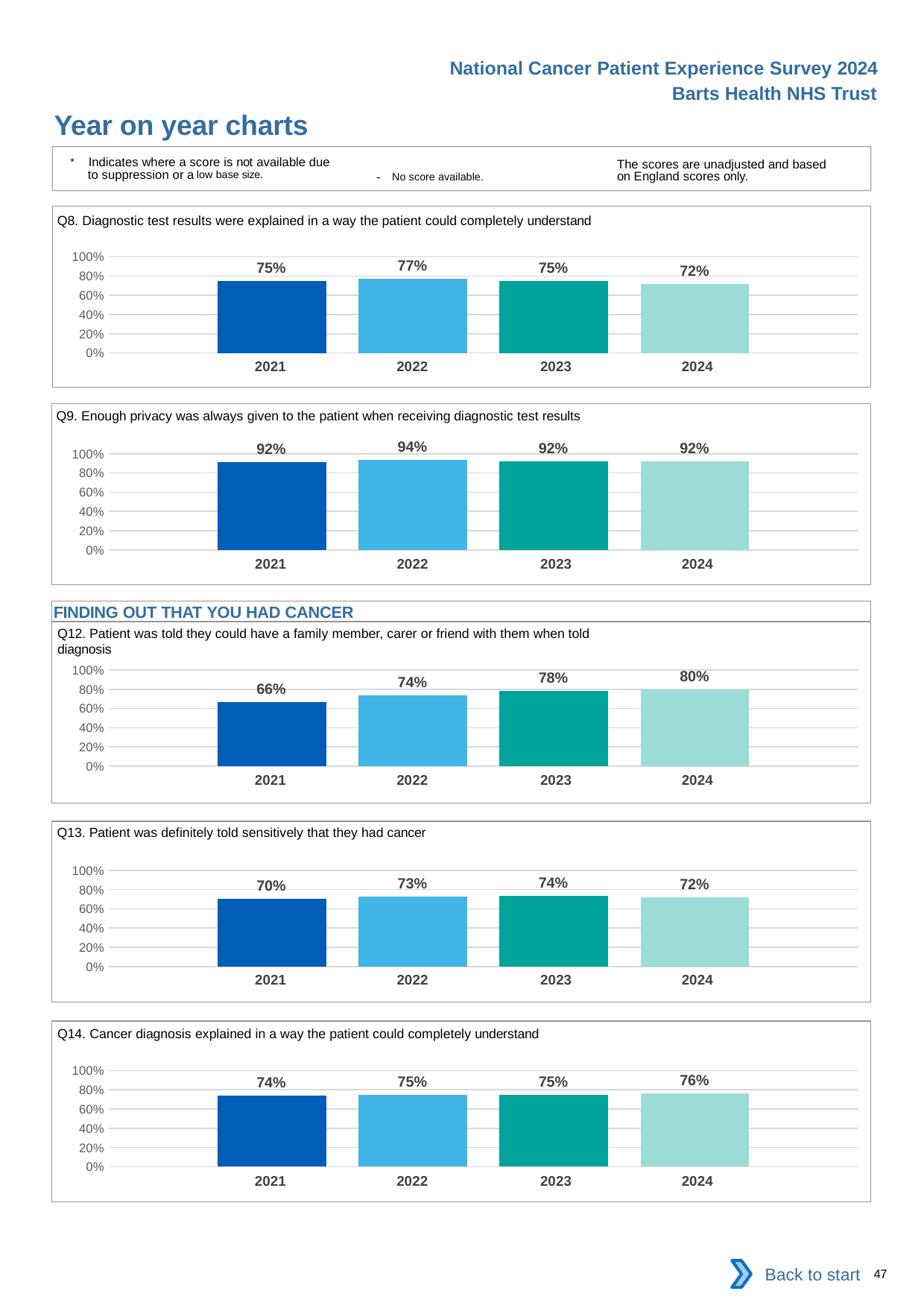
In the Q9 chart (Enough privacy was always given to the patient when receiving diagnostic test results), which year has the highest value? 2022 How many years are shown in the Q8 chart? 4 In the Q8 chart (Diagnostic test results were explained in a way the patient could completely understand), what is the value for 2022? 77% In the Q8 chart, which year has the lowest value? 2024 What kind of chart is the Q9 chart? bar chart In the Q14 chart, is the value for 2021 greater or less than 80%? less In the Q12 chart (Patient was told they could have a family member, carer or friend with them when told diagnosis), what is the difference between the 2024 and 2021 values? 14 percentage points In the Q13 chart, which is larger, the value for 2021 or the value for 2022? 2022 In the Q12 chart, do the values rise or fall from 2021 to 2024? rise In the Q13 chart (Patient was definitely told sensitively that they had cancer), what is the value for 2023? 74% In the Q9 chart, what is the value for 2024? 92% In the Q14 chart (Cancer diagnosis explained in a way the patient could completely understand), what is the value for 2024? 76%